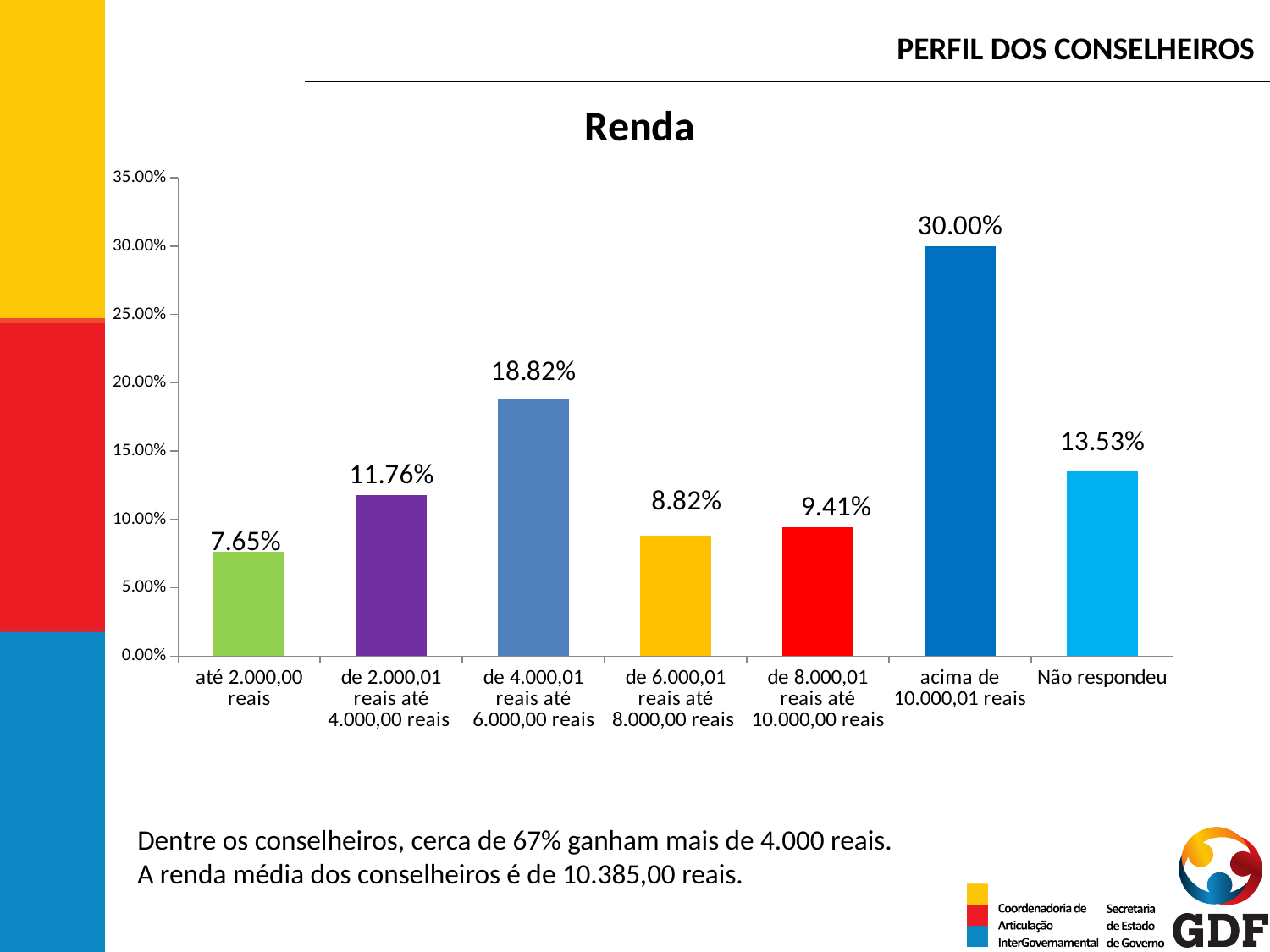
Which category has the highest value? acima de 10.000,01 reais What kind of chart is shown? bar chart What is the value for 'até 2.000,00 reais'? 7.65% Which category has the lowest value? até 2.000,00 reais How many categories are shown on the x axis? 7 What is the value for 'acima de 10.000,01 reais'? 30.00% What is the title of the chart? Renda Is the value for 'de 2.000,01 reais até 4.000,00 reais' greater or less than 10.00%? greater What is the difference between the values for 'acima de 10.000,01 reais' and 'de 4.000,01 reais até 6.000,00 reais'? 11.18% What is the value for 'Não respondeu'? 13.53% What is the difference between the values for 'Não respondeu' and 'de 2.000,01 reais até 4.000,00 reais'? 1.77% Which is larger: the value for 'de 6.000,01 reais até 8.000,00 reais' or 'de 8.000,01 reais até 10.000,00 reais'? de 8.000,01 reais até 10.000,00 reais